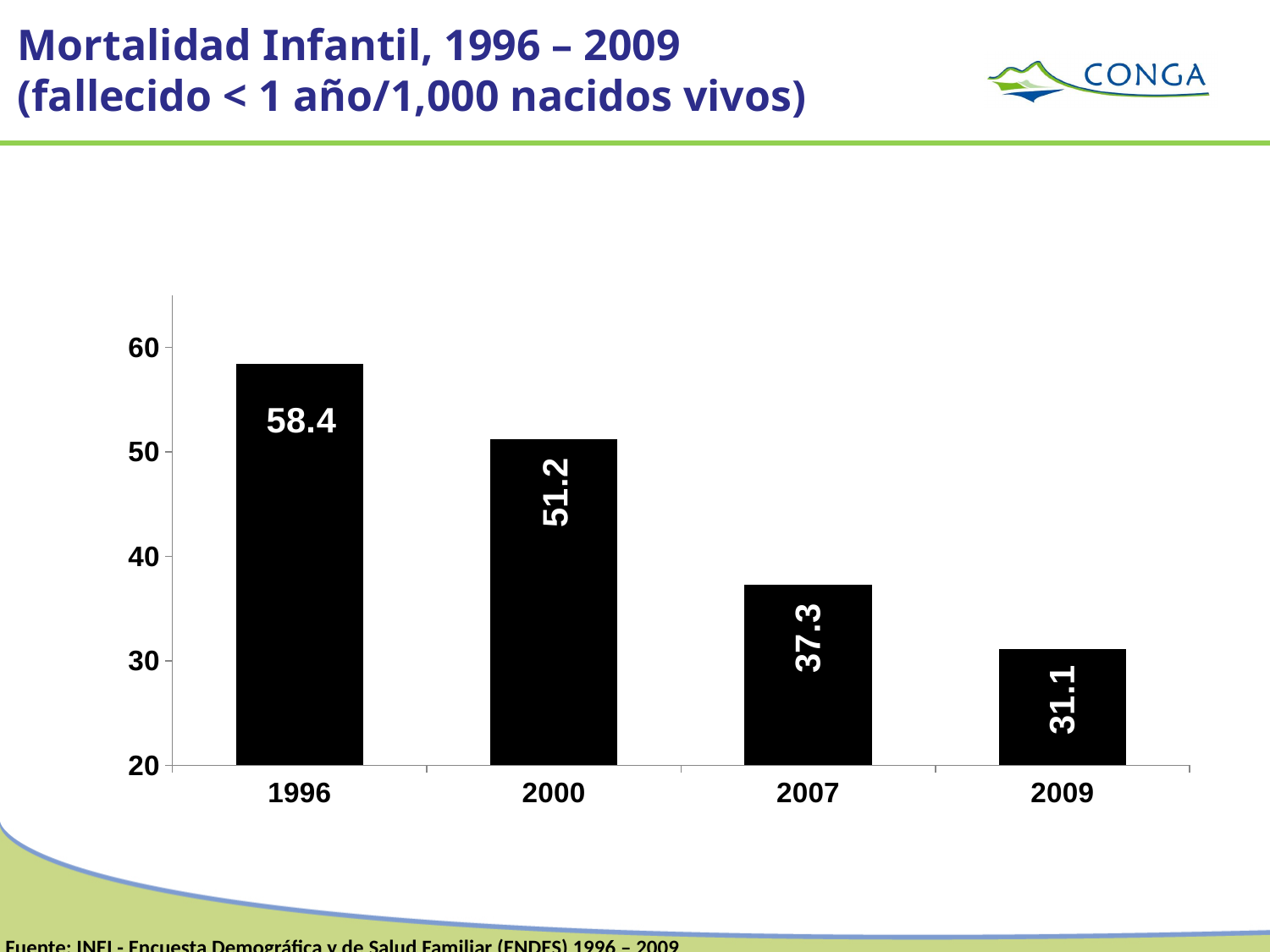
What is the difference between the values for 2000 and 2007? 13.9 Which is larger, the value for 2000 or the value for 2007? 2000 Which year has the lowest infant mortality value? 2009 What kind of chart is shown on the slide? Bar chart What is the infant mortality value for 2000? 51.2 Which year has the highest infant mortality value? 1996 How many years are shown on the chart? 4 What is the infant mortality value for 2009? 31.1 What is the infant mortality value for 2007? 37.3 Do the values rise or fall from 1996 to 2009? Fall What is the difference between the values for 1996 and 2009? 27.3 What is the infant mortality value for 1996? 58.4